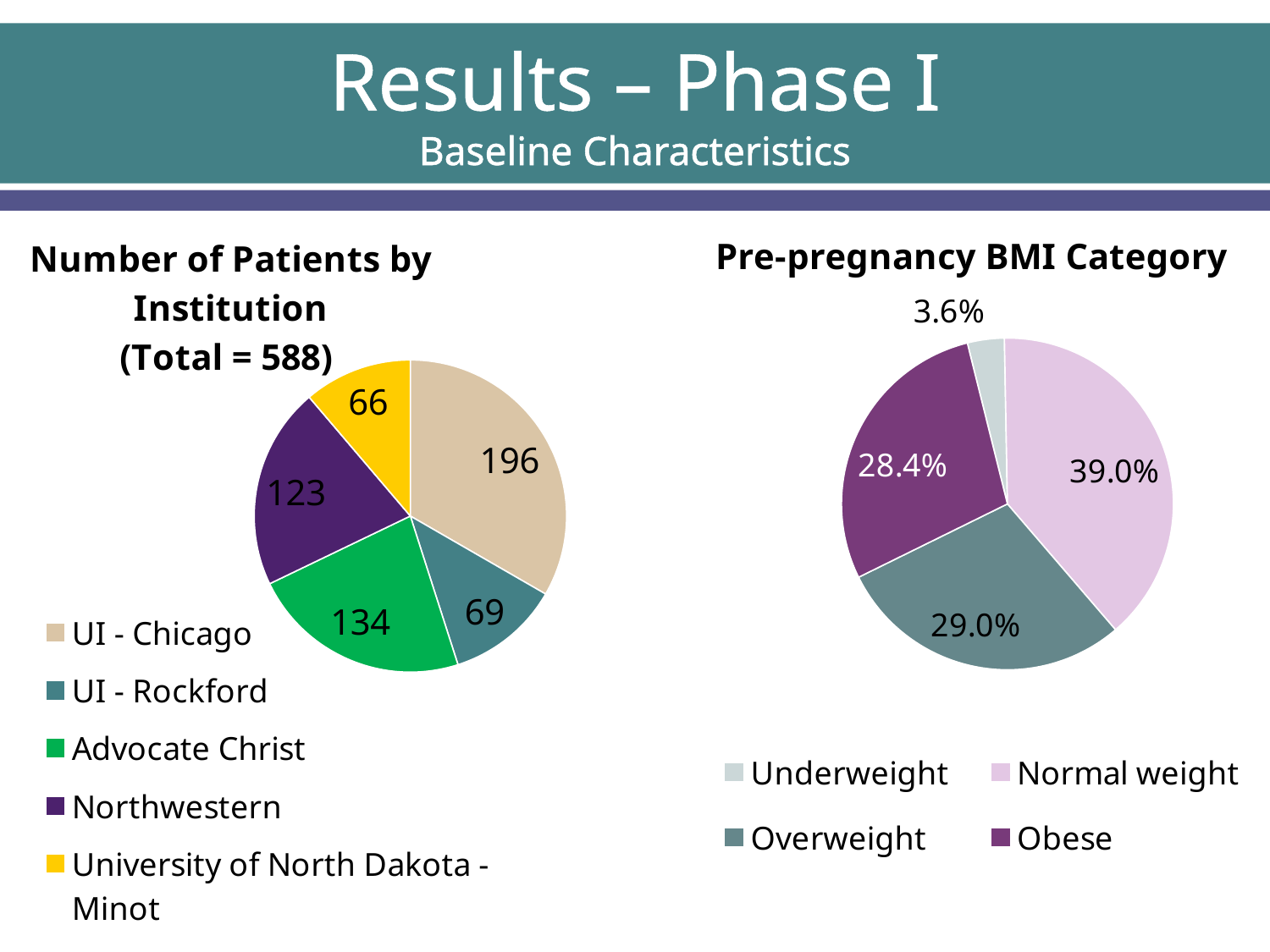
In the 'Number of Patients by Institution' chart, how many patients are from UI - Chicago? 196 In the 'Number of Patients by Institution' chart, what is the total number of patients stated in the title? 588 In the 'Number of Patients by Institution' chart, which institution has the most patients? UI - Chicago In the 'Pre-pregnancy BMI Category' chart, which is larger, the Overweight share or the Obese share? Overweight In the 'Pre-pregnancy BMI Category' chart, which BMI category has the largest share? Normal weight In the 'Number of Patients by Institution' chart, how many institutions are shown? 5 In the 'Number of Patients by Institution' chart, what is the difference between the number of patients from Advocate Christ and from UI - Rockford? 65 What type of chart is the 'Pre-pregnancy BMI Category' chart? Pie chart In the 'Pre-pregnancy BMI Category' chart, what percentage of patients are Underweight? 3.6% In the 'Number of Patients by Institution' chart, how many patients are from Northwestern? 123 In the 'Number of Patients by Institution' chart, which institution has the fewest patients? University of North Dakota - Minot In the 'Pre-pregnancy BMI Category' chart, what percentage of patients are Obese? 28.4%